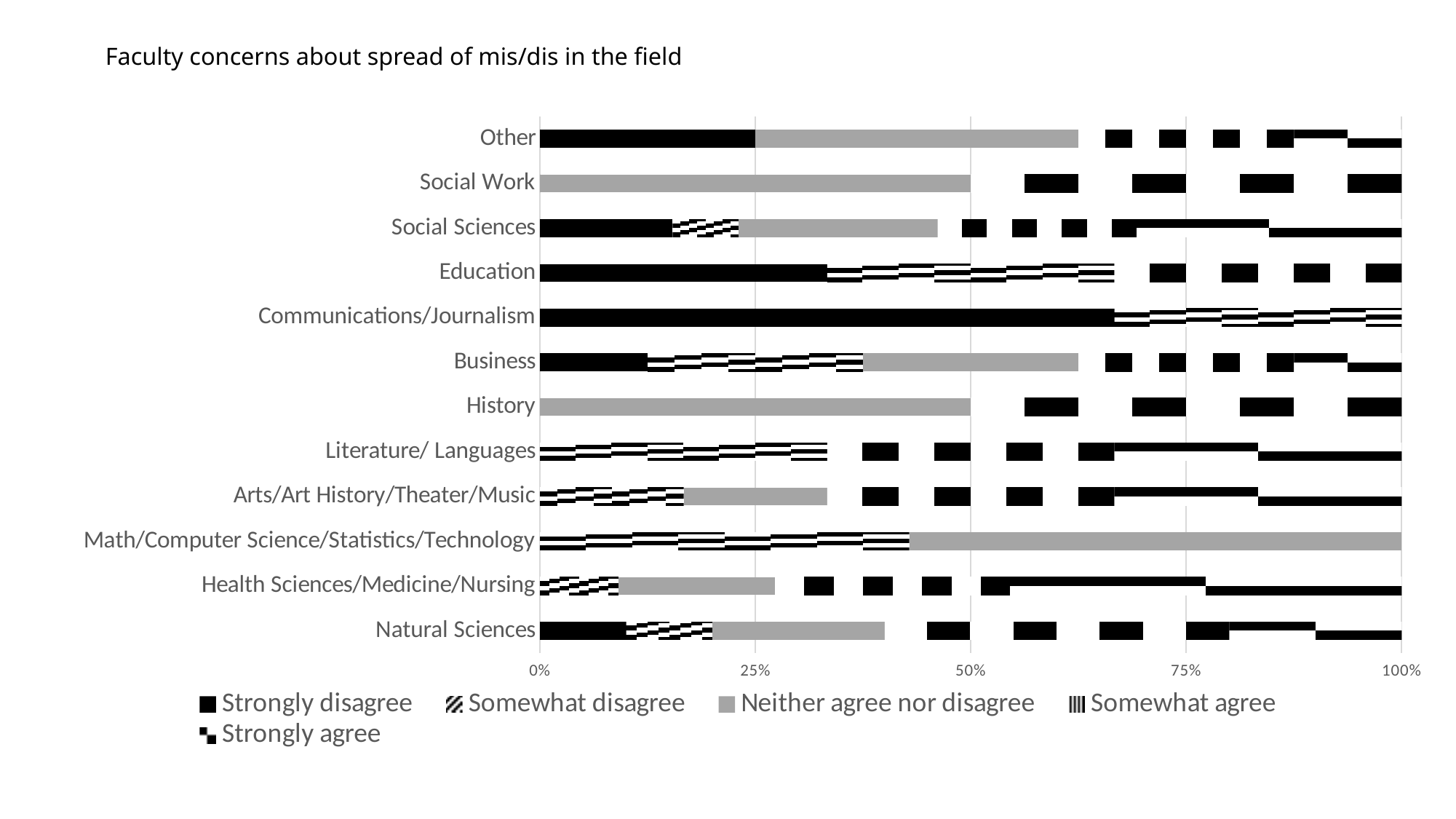
Which category has the largest Neither agree nor disagree share? Math/Computer Science/Statistics/Technology What kind of chart is shown on the slide? Stacked bar chart Is the Strongly disagree share for Education greater or less than 25%? greater What is the title of the chart? Faculty concerns about spread of mis/dis in the field Which category has the largest Strongly disagree share? Communications/Journalism Which series is shown in solid grey in the legend? Neither agree nor disagree How many series does the legend list? 5 Which has the larger Strongly disagree share, Education or Business? Education Is the Strongly disagree share for Communications/Journalism greater or less than 50%? greater How many categories (fields) are plotted on the chart? 12 Is the Strongly disagree share for Business greater or less than 25%? less